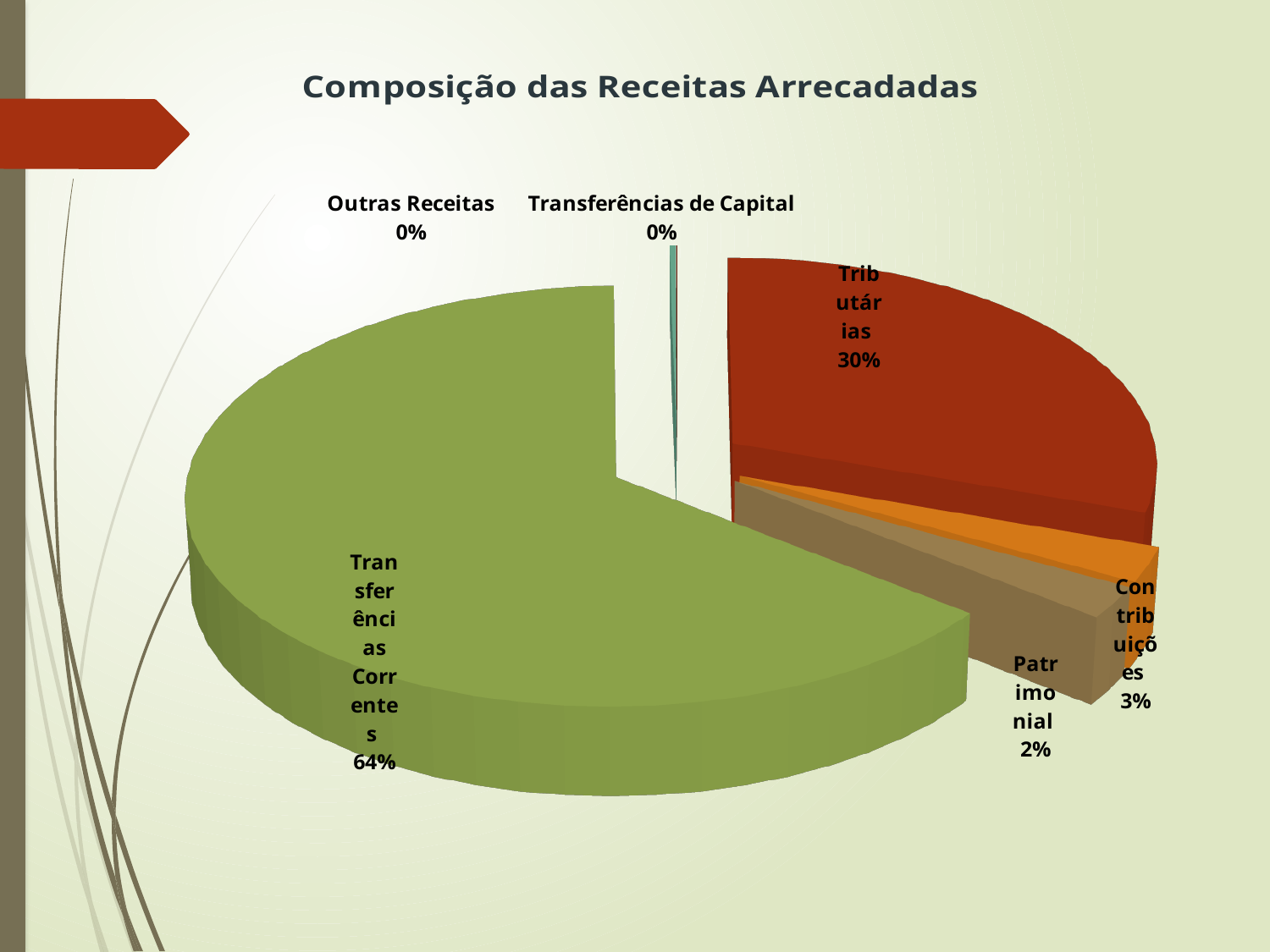
What percentage is shown for Patrimonial? 2% Which is larger, the share for Contribuições or the share for Patrimonial? Contribuições What percentage is shown for Tributárias? 30% What is the difference in percentage points between Transferências Correntes and Tributárias? 34 percentage points What kind of chart is shown on the slide? Pie chart What colour is the Transferências Correntes slice? Green What percentage is shown for Contribuições? 3% How many categories are labelled on the pie chart? 6 What share of the pie does Transferências Correntes represent? 64% What percentage is shown for Transferências de Capital? 0% What is the title of the chart? Composição das Receitas Arrecadadas Which category has the largest share of the pie? Transferências Correntes